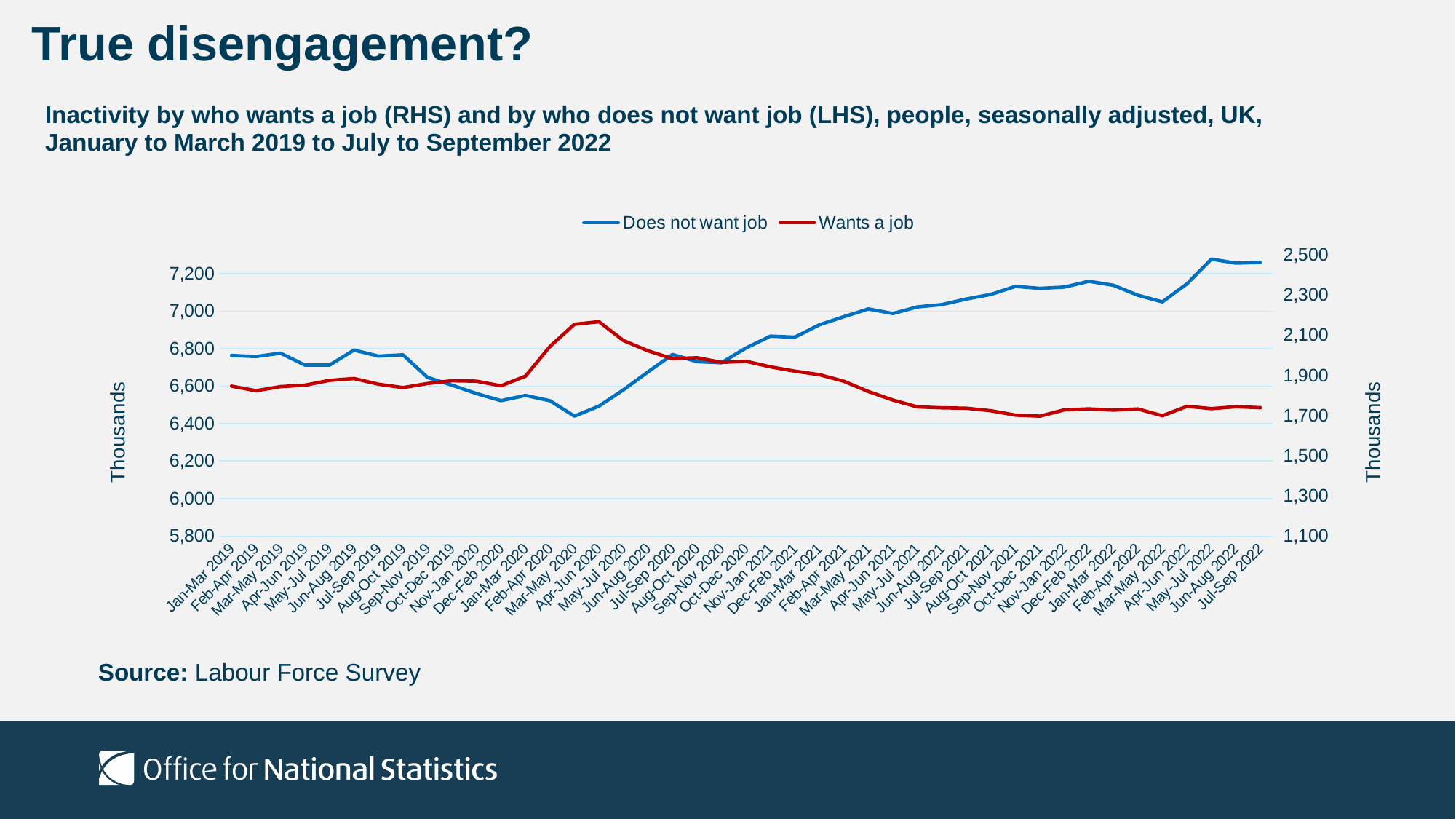
Which series is drawn in red? Wants a job Is the value for Does not want job in Apr-Jun 2020 greater or less than 6,600? less Is the value for Wants a job in Jul-Sep 2022 greater or less than 1,900? less How many time periods are plotted along the x axis? 43 Is the value for Does not want job in Jul-Sep 2022 greater or less than 7,200? greater What is the source given for the chart? Labour Force Survey What kind of chart is shown on the slide? Line chart Does the Wants a job series rise or fall between May-Jul 2020 and Jul-Sep 2022? Fall In which period does the Wants a job series reach its highest value? Apr-Jun 2020 How many series does the legend list? 2 In which period does the Does not want job series reach its lowest value? Mar-May 2020